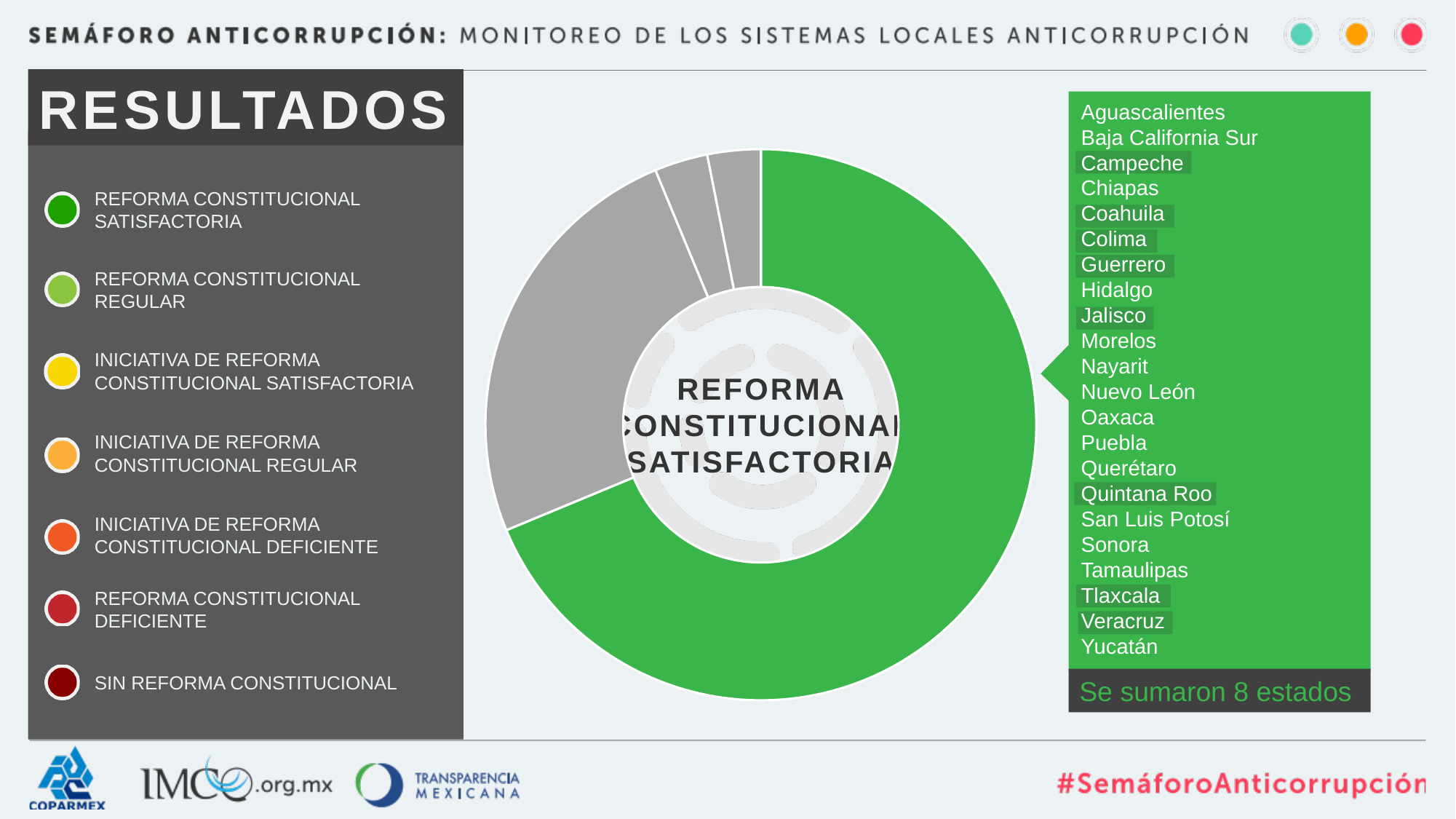
Which state appears first in the list next to the pie chart? Aguascalientes Which category does the largest slice of the pie chart represent? Reforma Constitucional Satisfactoria Which is larger in the pie chart: the green slice or the largest grey slice? The green slice How many states are listed in the green box next to the pie chart? 22 According to the note under the list of states, how many states were added (se sumaron)? 8 estados What text is written in the centre of the pie chart? Reforma Constitucional Satisfactoria How many categories does the legend on the left of the slide list? 7 How many slices does the pie chart have? 4 What colour is the largest slice of the pie chart? Green How many grey slices are in the pie chart? 3 What kind of chart is shown on the slide? Doughnut chart Which state appears last in the list next to the pie chart? Yucatán